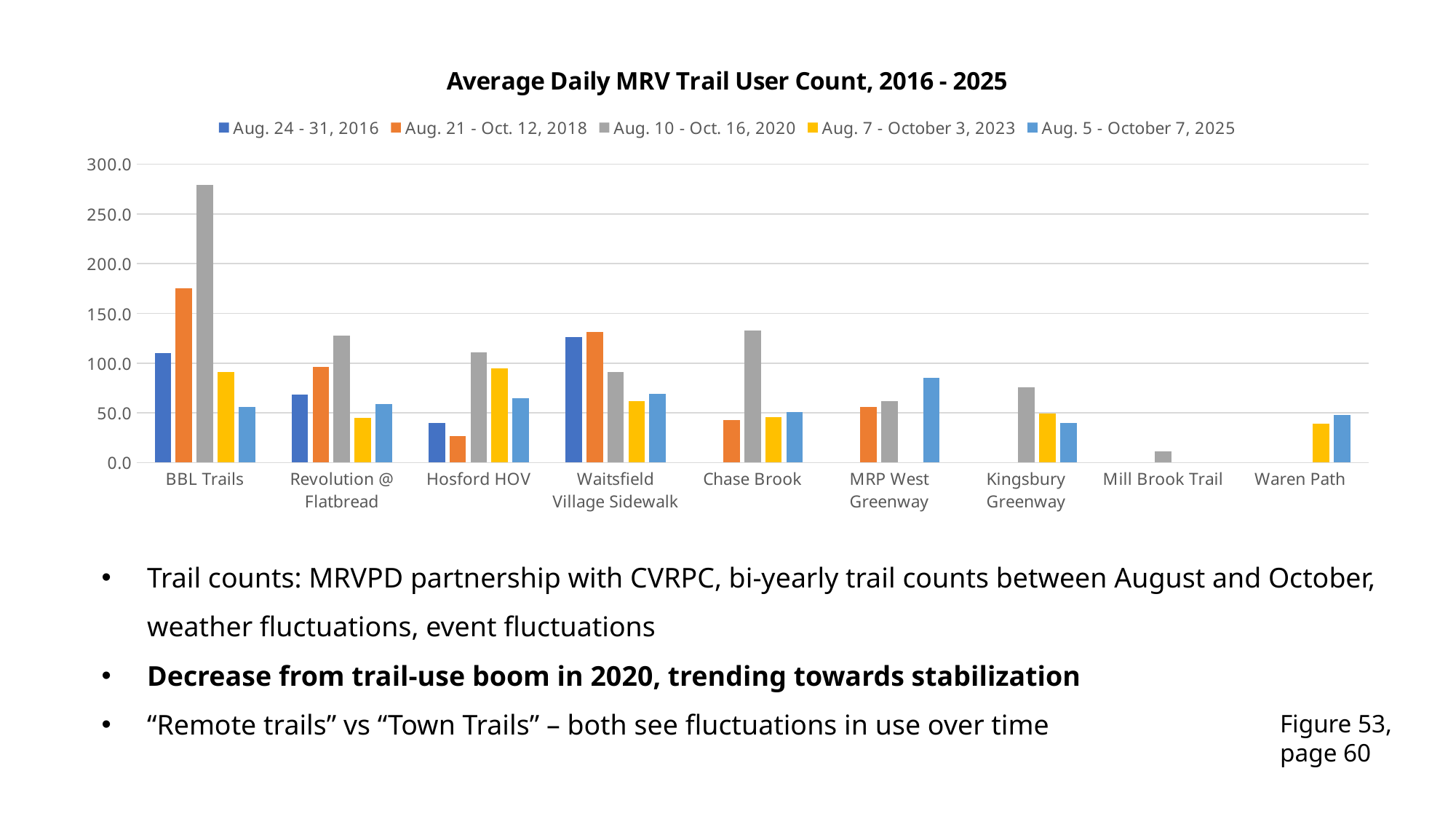
How many trail categories are shown on the x axis? 9 For Hosford HOV, which is larger: the Aug. 24 - 31, 2016 value or the Aug. 10 - Oct. 16, 2020 value? Aug. 10 - Oct. 16, 2020 What kind of chart is shown on the slide? bar chart Is the value for Waitsfield Village Sidewalk in the Aug. 21 - Oct. 12, 2018 series greater or less than 100.0? greater Which trail has the highest value for the Aug. 10 - Oct. 16, 2020 series? BBL Trails Which trail has the lowest value for the Aug. 10 - Oct. 16, 2020 series? Mill Brook Trail How many series does the legend list? 5 Which series is shown in grey in the legend? Aug. 10 - Oct. 16, 2020 Is the value for BBL Trails in the Aug. 10 - Oct. 16, 2020 series greater or less than 250.0? greater What is the title of the chart? Average Daily MRV Trail User Count, 2016 - 2025 For MRP West Greenway, which is larger: the Aug. 21 - Oct. 12, 2018 value or the Aug. 5 - October 7, 2025 value? Aug. 5 - October 7, 2025 Is the value for Mill Brook Trail in the Aug. 10 - Oct. 16, 2020 series greater or less than 50.0? less